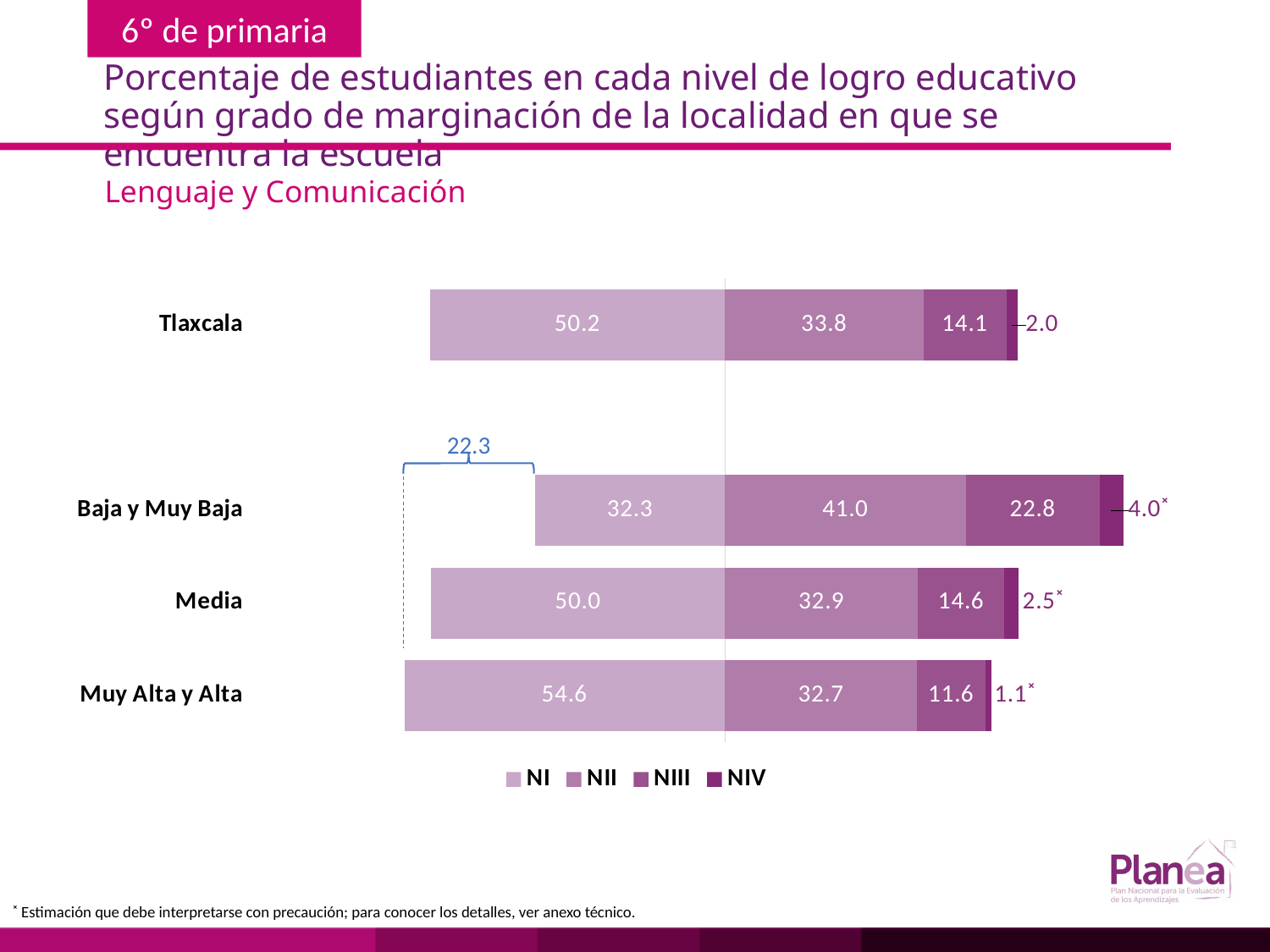
Which is larger, the NII value for Tlaxcala or the NII value for Media? Tlaxcala What is the NII value for Baja y Muy Baja? 41.0 What is the total of the stacked bar for Media? 100.0 What is the difference between the NIII values for Baja y Muy Baja and Tlaxcala? 8.7 What type of chart is shown on the slide? stacked bar chart What is the NI value for Tlaxcala? 50.2 How many categories are shown on the chart? 4 What is the NIV value for Muy Alta y Alta? 1.1 Which category has the lowest NIII value? Muy Alta y Alta What is the NIII value for Media? 14.6 How many series does the legend list? 4 Which category has the highest NI value? Muy Alta y Alta